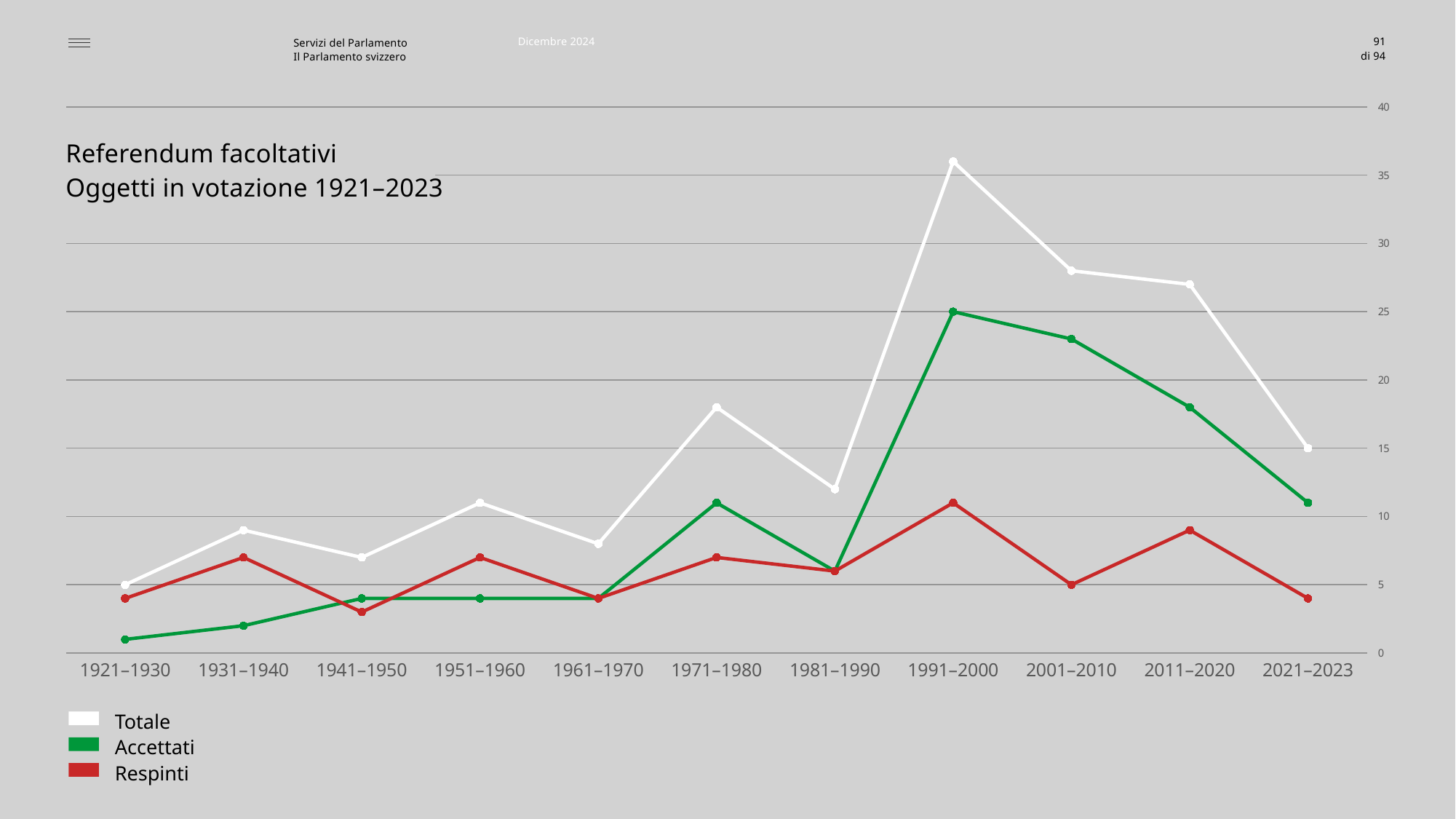
In which period does Totale reach its highest value? 1991–2000 What type of chart is shown on the slide? line chart How many periods are shown on the x axis? 11 Which is larger for 2001–2010, Accettati or Respinti? Accettati What is the value of Accettati for 1991–2000? 25 Is the value of Respinti for 2011–2020 greater or less than 10? less Is the value of Totale for 1991–2000 greater or less than 35? greater In which period is Accettati at its lowest value? 1921–1930 What is the value of Totale for 1921–1930? 5 What is the value of Totale for 2021–2023? 15 Does the Totale line rise or fall from 1991–2000 to 2021–2023? fall How many series does the legend list? 3